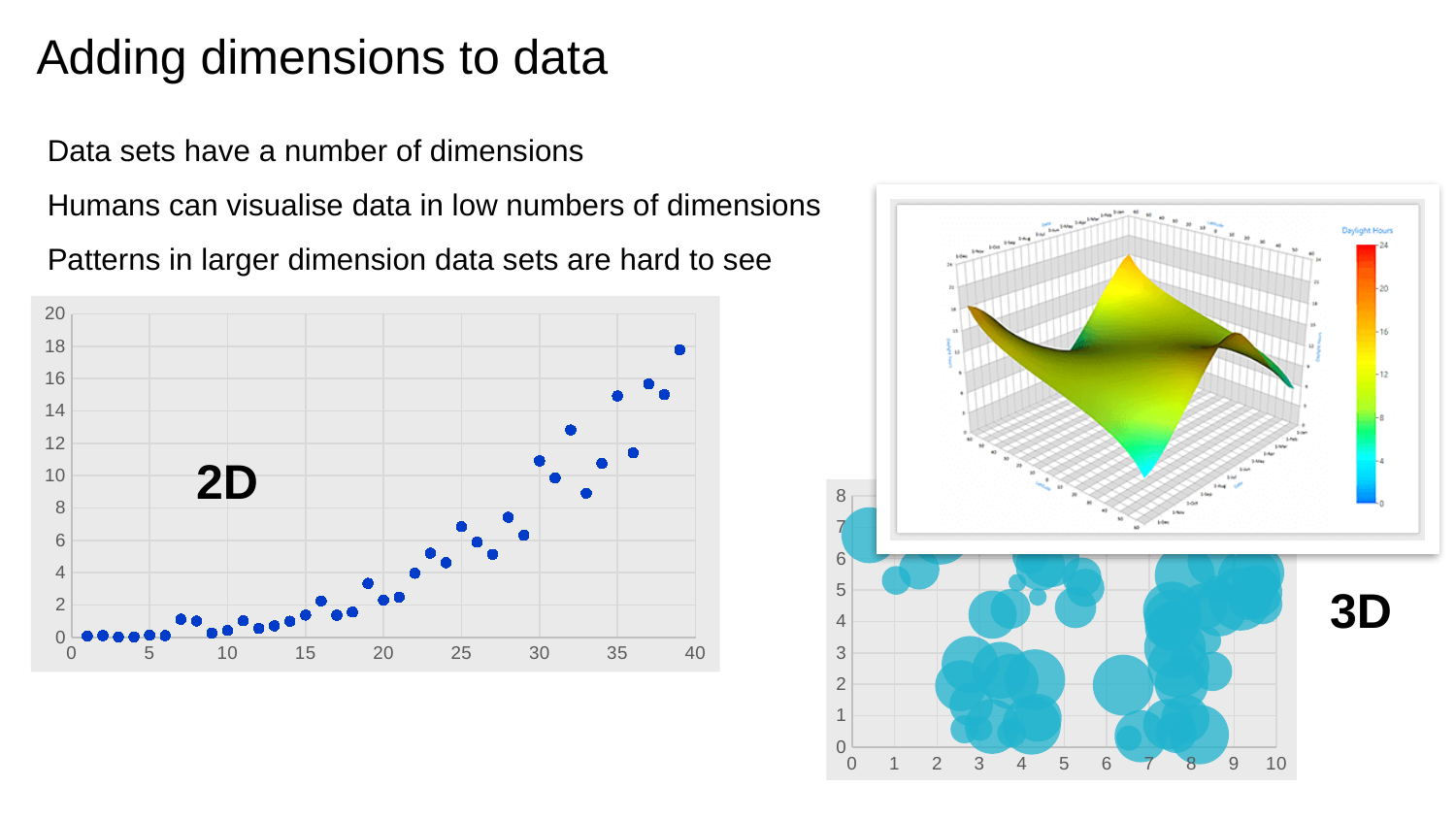
In the scatter chart on the left, what is the highest value shown on the x axis? 40 What kind of chart is the chart at the top right with the "Daylight Hours" colour scale? 3D surface chart In the bubble chart at the bottom right, what is the highest value shown on the y axis? 8 In the scatter chart on the left, is the y value of the point at x = 25 greater or less than 6? greater In the scatter chart on the left, what is the highest value shown on the y axis? 20 In the scatter chart on the left, do the y values generally rise or fall as x increases? rise What kind of chart is the chart at the bottom right labelled "3D"? bubble chart In the scatter chart on the left, is the y value of the point at x = 10 greater or less than 2? less In the scatter chart on the left, is the y value of the point at x = 39 greater or less than 16? greater What kind of chart is the chart on the left labelled "2D"? scatter chart